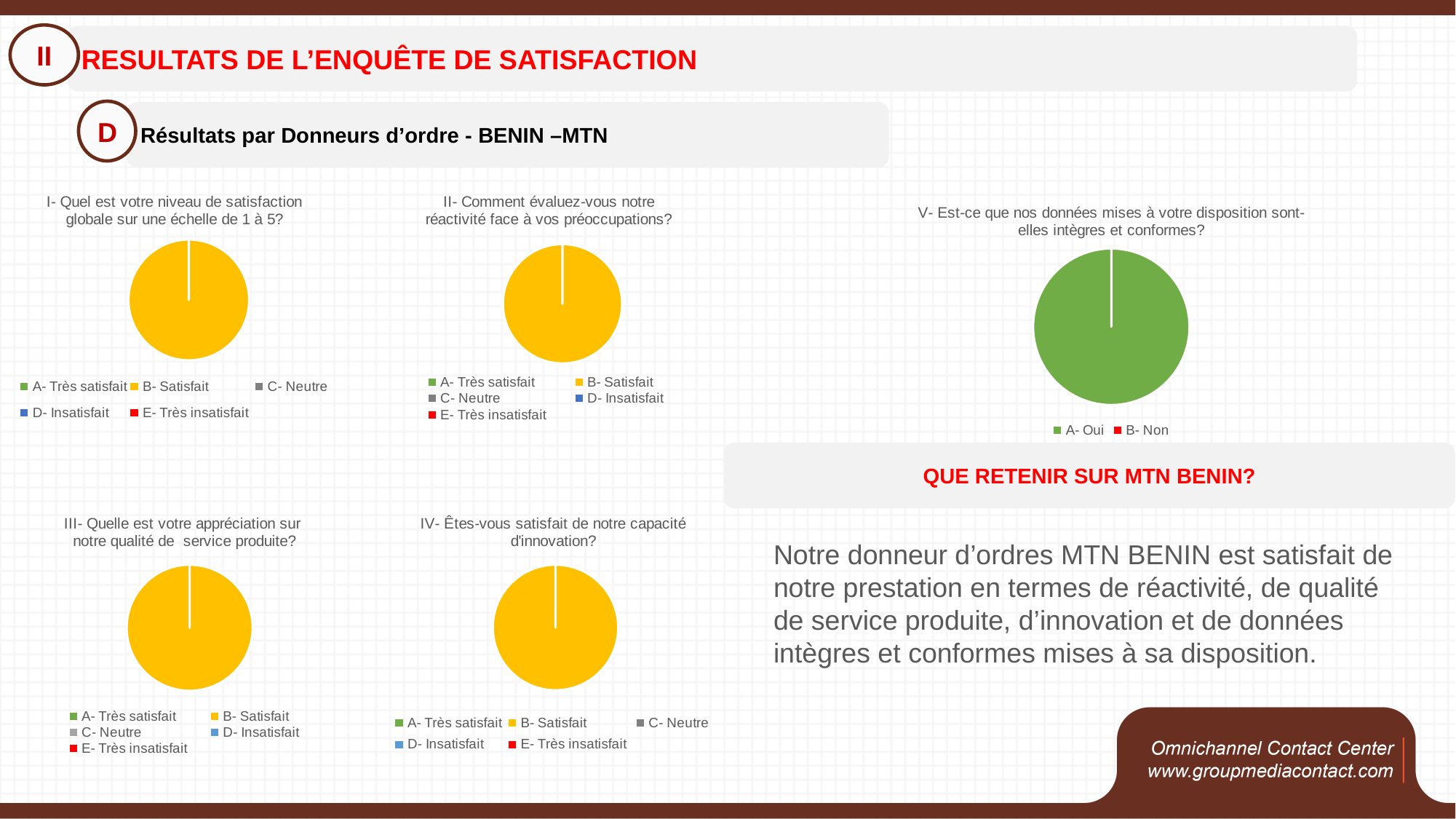
In the chart for question V (données intègres et conformes), which category makes up the largest slice of the pie? A- Oui How many entries does the legend list for the chart for question I (satisfaction globale)? 5 Which legend entry is shown in red in the chart for question V (données intègres et conformes)? B- Non In the chart for question III (qualité de service produite), which category makes up the largest slice of the pie? B- Satisfait In the chart for question I (satisfaction globale), which category makes up the largest slice of the pie? B- Satisfait What kind of chart is used for question I, "Quel est votre niveau de satisfaction globale sur une échelle de 1 à 5?"? Pie chart What colour is the pie in the chart for question V (données intègres et conformes)? Green In the chart for question II (réactivité), is the slice for A- Très satisfait larger or smaller than the slice for B- Satisfait? Smaller How many entries does the legend list for the chart for question V (données intègres et conformes)? 2 How many charts are shown on the slide? 5